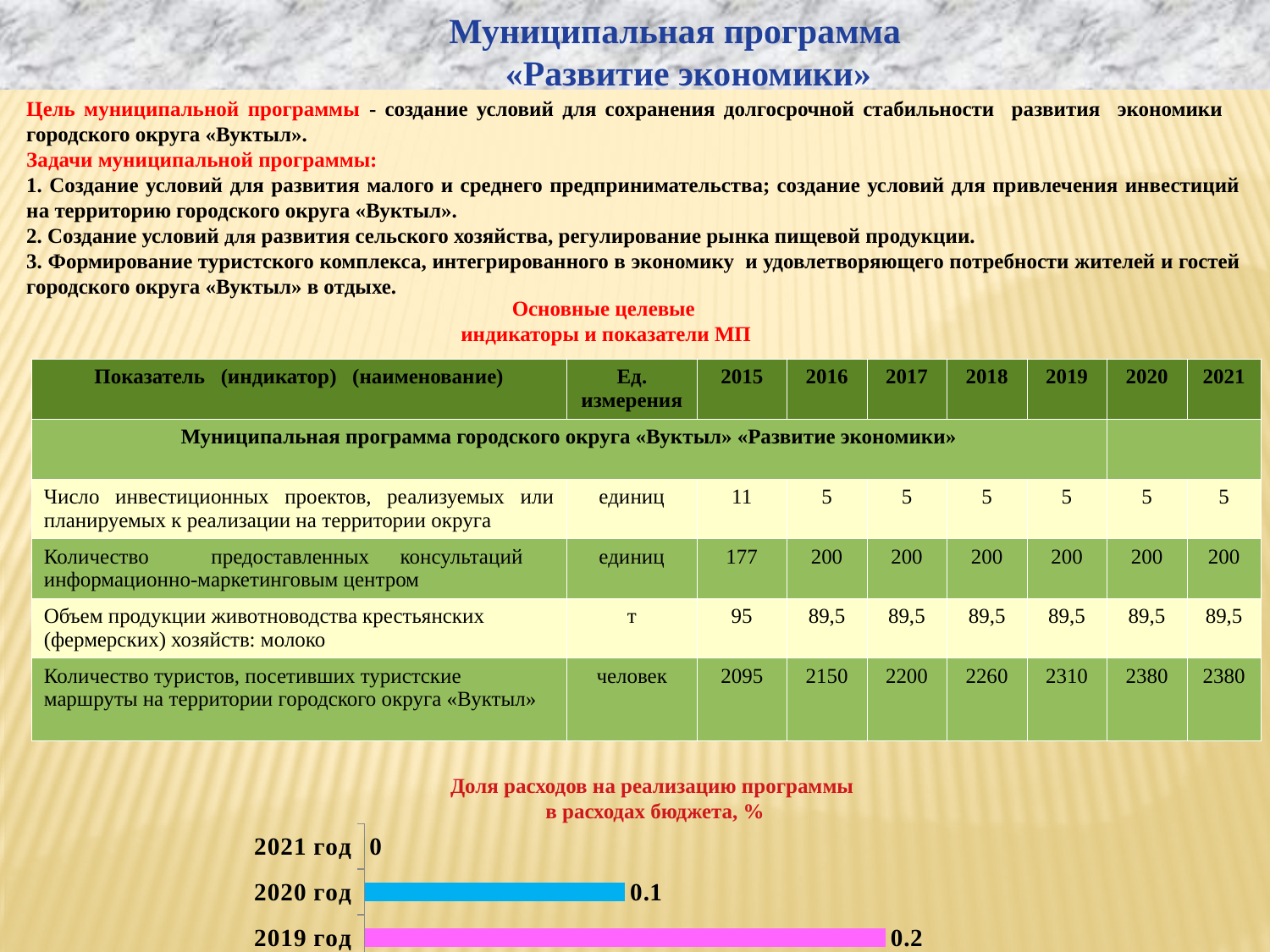
What is the value for 2020 год in the chart? 0.1 How many categories (years) are shown in the chart? 3 What is the value for 2019 год in the chart? 0.2 What is the difference between the values for 2019 год and 2021 год in the chart? 0.2 Do the values in the chart rise or fall from 2019 год to 2021 год? fall What is the title of the chart at the bottom of the slide? Доля расходов на реализацию программы в расходах бюджета, % What is the value for 2021 год in the chart? 0 Which year has the lowest value in the chart? 2021 год What type of chart is shown at the bottom of the slide? bar chart Which year has the highest value in the chart? 2019 год What is the difference between the values for 2019 год and 2020 год in the chart? 0.1 Which is larger in the chart, the value for 2019 год or the value for 2020 год? 2019 год